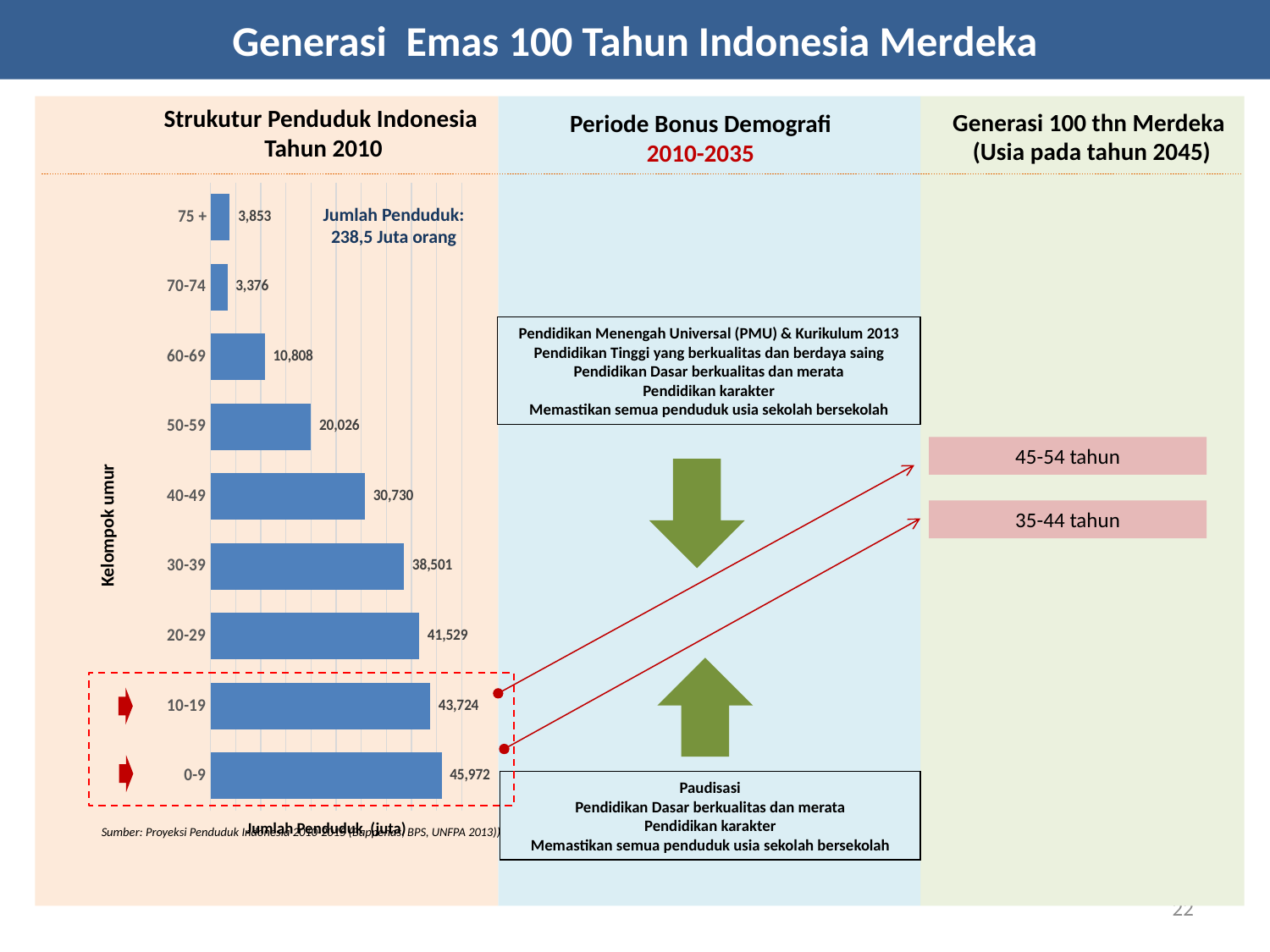
What is the label on the vertical axis of the chart? Kelompok umur What kind of chart is shown on the slide? bar chart What is the value for the 0-9 age group? 45,972 Which is larger, the value for 30-39 or the value for 40-49? 30-39 What is the value for the 40-49 age group? 30,730 Which age group has the lowest value? 70-74 Which age group has the highest value? 0-9 What is the title of the chart? Strukutur Penduduk Indonesia Tahun 2010 What is the value for the 70-74 age group? 3,376 How many age groups are shown in the chart? 9 What is the difference between the values for the 10-19 and 20-29 age groups? 2,195 What is the difference between the values for the 60-69 and 50-59 age groups? 9,218